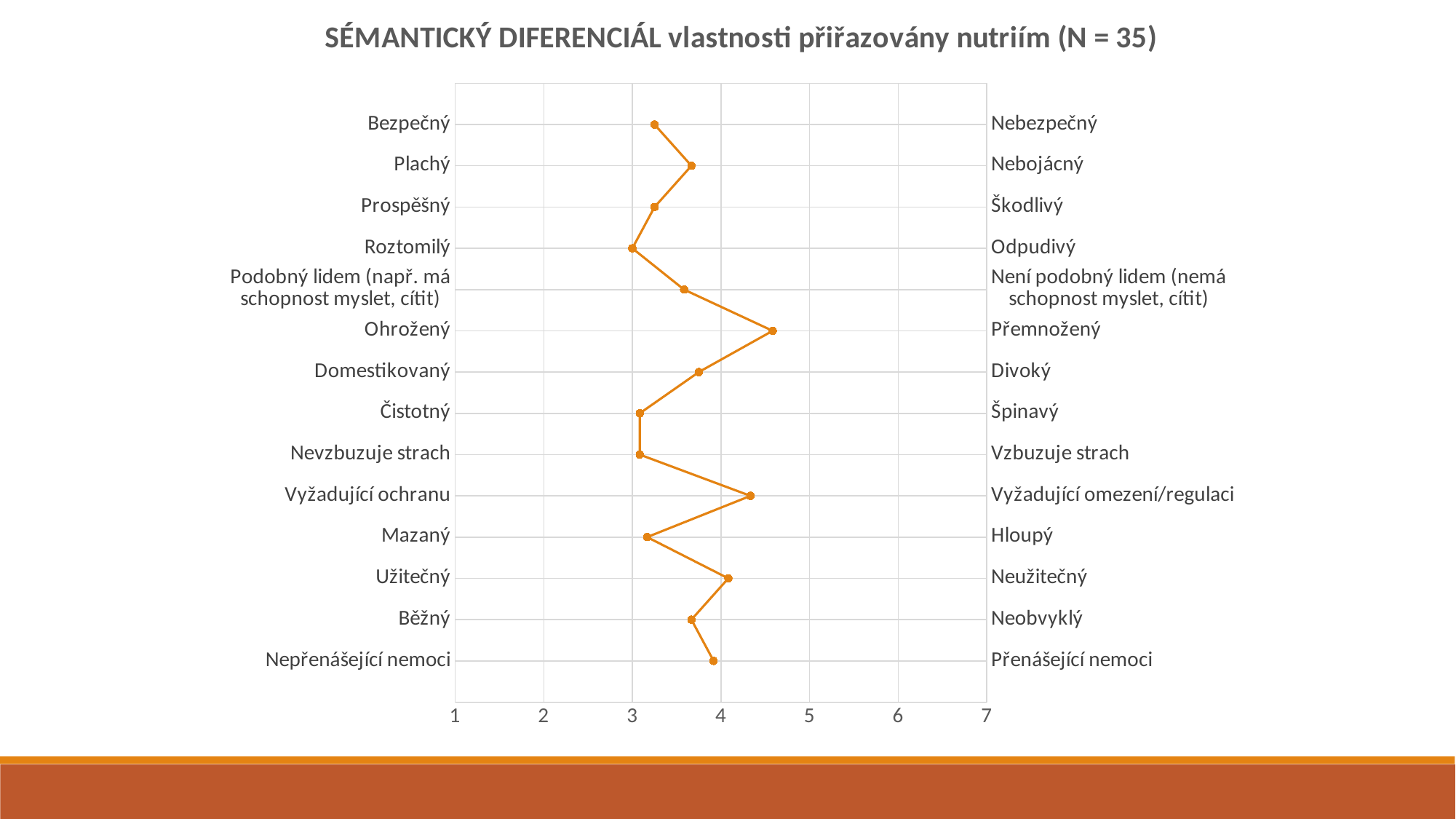
Is the value for Vyžadující ochranu / Vyžadující omezení/regulaci greater or less than 4? greater Which has the larger value: Ohrožený / Přemnožený or Domestikovaný / Divoký? Ohrožený / Přemnožený Is the value for Mazaný / Hloupý greater or less than 4? less Is the value for Ohrožený / Přemnožený greater or less than 4? greater Which category has the highest value on the chart? Ohrožený / Přemnožený What is the range of the horizontal axis on the chart? 1 to 7 What is the title of the chart? SÉMANTICKÝ DIFERENCIÁL vlastnosti přiřazovány nutriím (N = 35) What kind of chart is shown on the slide? line chart Which has the larger value: Vyžadující ochranu / Vyžadující omezení/regulaci or Mazaný / Hloupý? Vyžadující ochranu / Vyžadující omezení/regulaci How many attribute pairs (categories) are plotted on the chart? 14